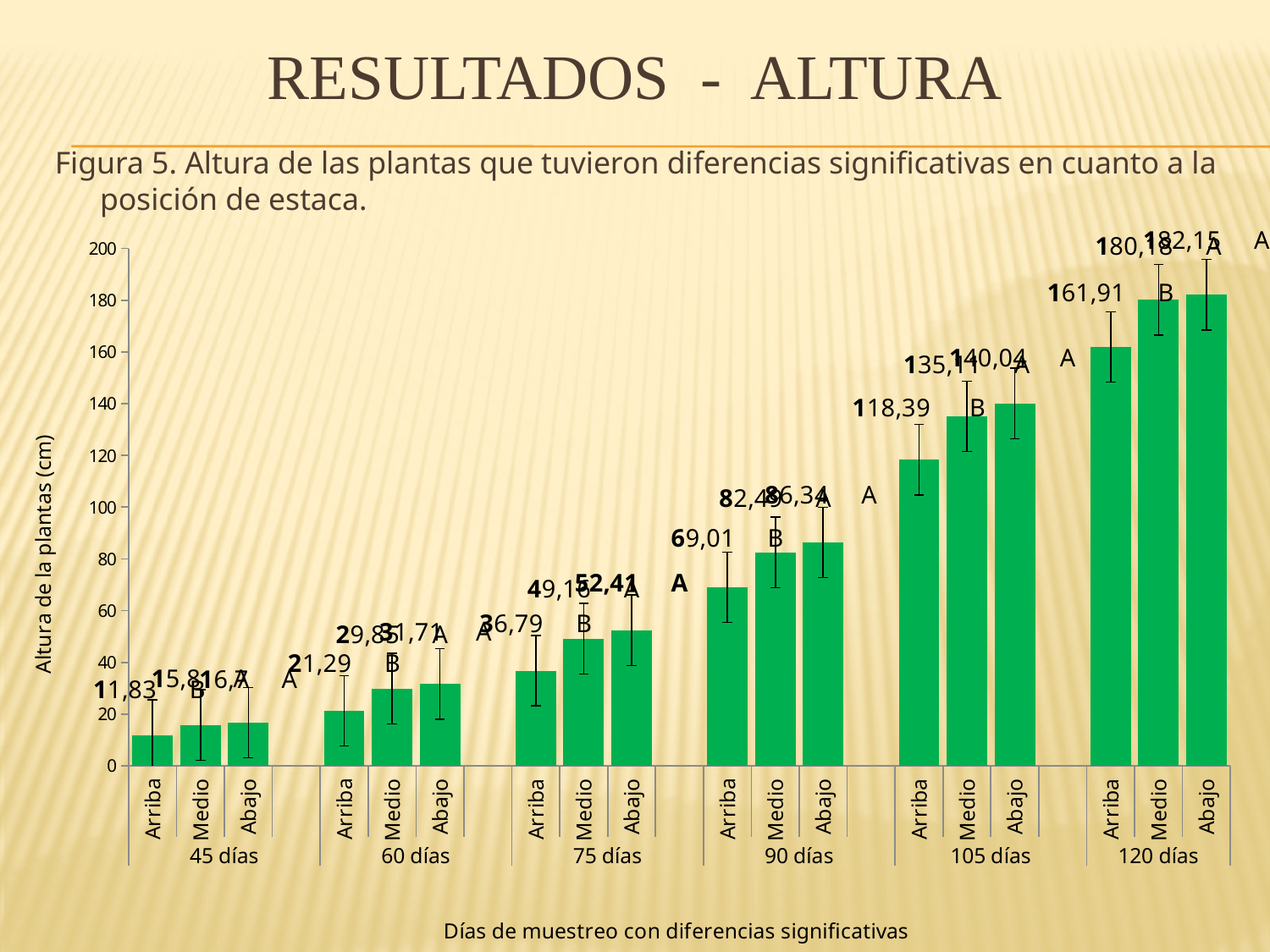
What kind of chart is shown on the slide? bar chart Which is larger: the Arriba value at 75 días or the Arriba value at 60 días? Arriba at 75 días Which bar has the highest value in the chart? Abajo at 120 días What is the difference between the Arriba values at 120 días and 105 días? 43,52 Do the Arriba values rise or fall as the sampling days increase from 45 días to 120 días? rise What is the plant height for Abajo at 105 días? 140,04 What is the plant height for Arriba at 90 días? 69,01 Which bar has the lowest value in the chart? Arriba at 45 días How many sampling-day groups are shown on the x axis? 6 What is the plant height for Arriba at 120 días? 161,91 Is the value for Abajo at 90 días greater or less than 80? greater What is the plant height for Arriba at 45 días? 11,83